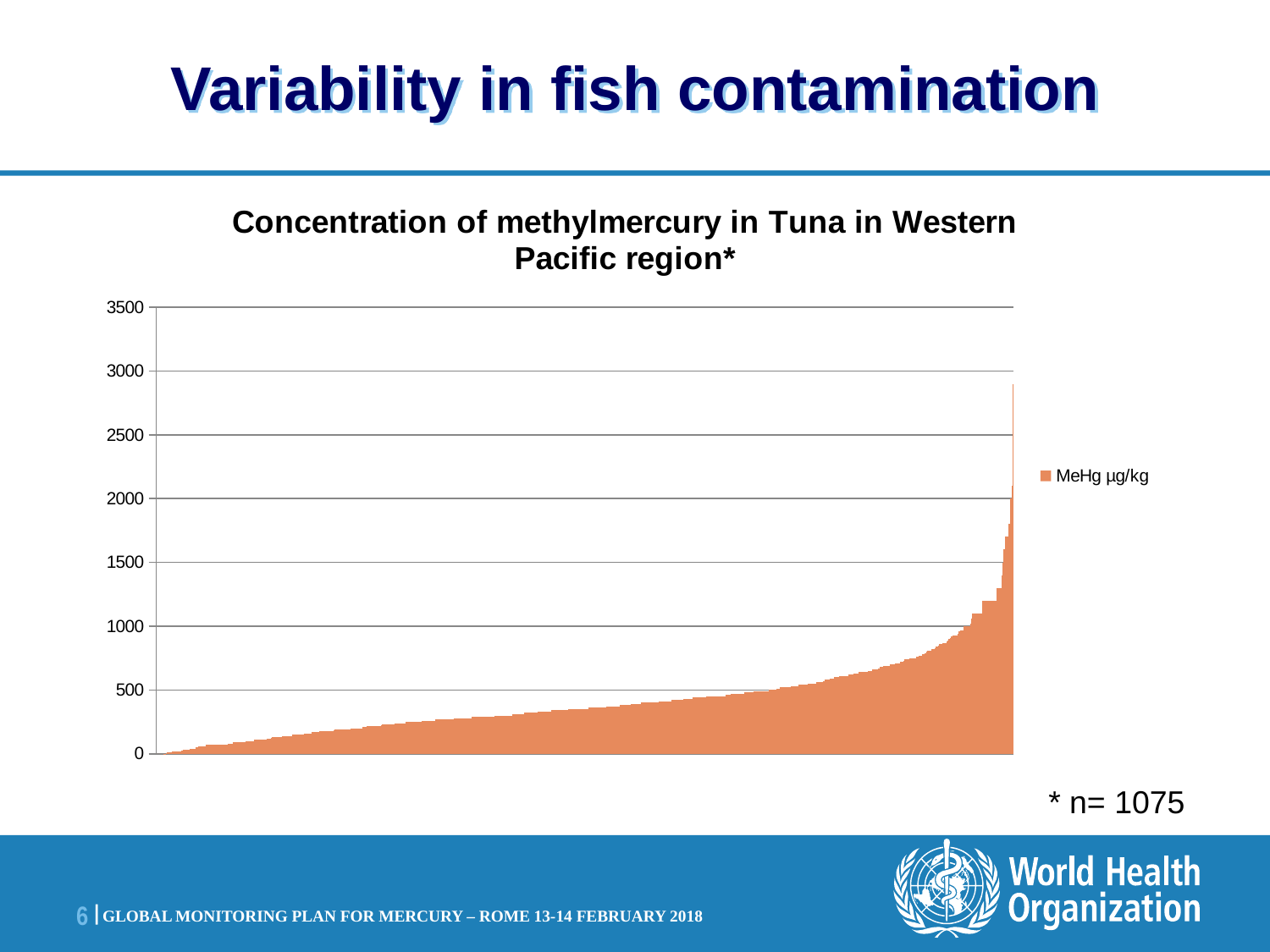
What is the series name shown in the legend? MeHg µg/kg Is the highest value in the chart greater or less than 2500? greater Is the highest value in the chart greater or less than 3000? less Is the value of the bar at the middle of the x axis greater or less than 1000? less How many series does the legend list? 1 What kind of chart is shown on the slide? bar chart Do the values rise or fall from left to right along the x axis? rise What is the title of the chart? Concentration of methylmercury in Tuna in Western Pacific region* According to the footnote, how many samples (n) does the chart cover? 1075